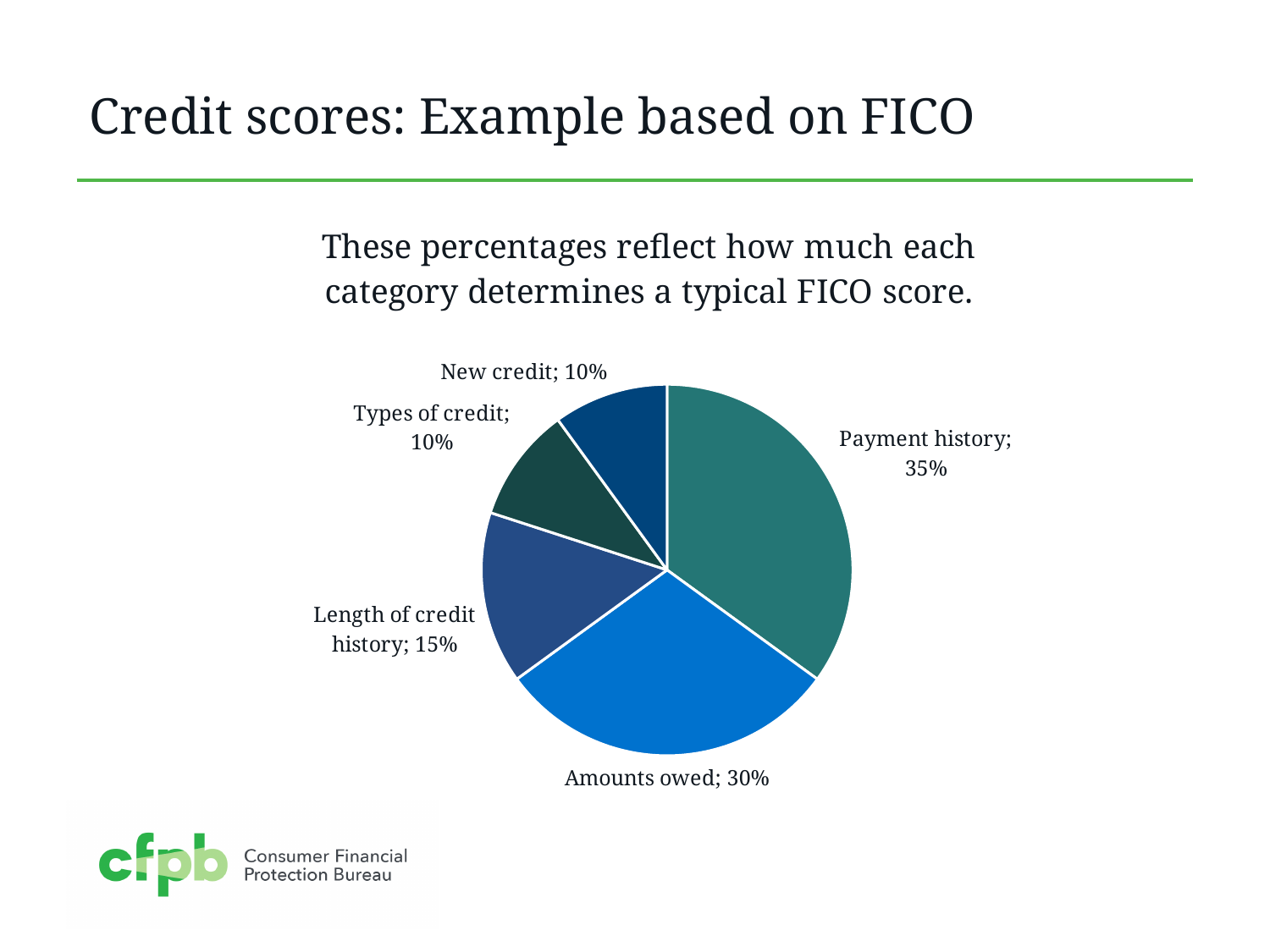
What kind of chart is shown on the slide? Pie chart What is the difference between the Payment history share and the Amounts owed share? 5% What percentage of a typical FICO score is determined by Payment history? 35% How many categories are shown in the pie chart? 5 What percentage does Amounts owed account for in the pie chart? 30% What is the title of the slide containing the pie chart? Credit scores: Example based on FICO Which category has the largest share of the pie chart? Payment history Which is larger, the share for Length of credit history or the share for Types of credit? Length of credit history What is the difference between the Amounts owed share and the Length of credit history share? 15% What percentage is shown for New credit? 10% What is the value shown for Length of credit history? 15% What is the combined share of Payment history and Amounts owed? 65%